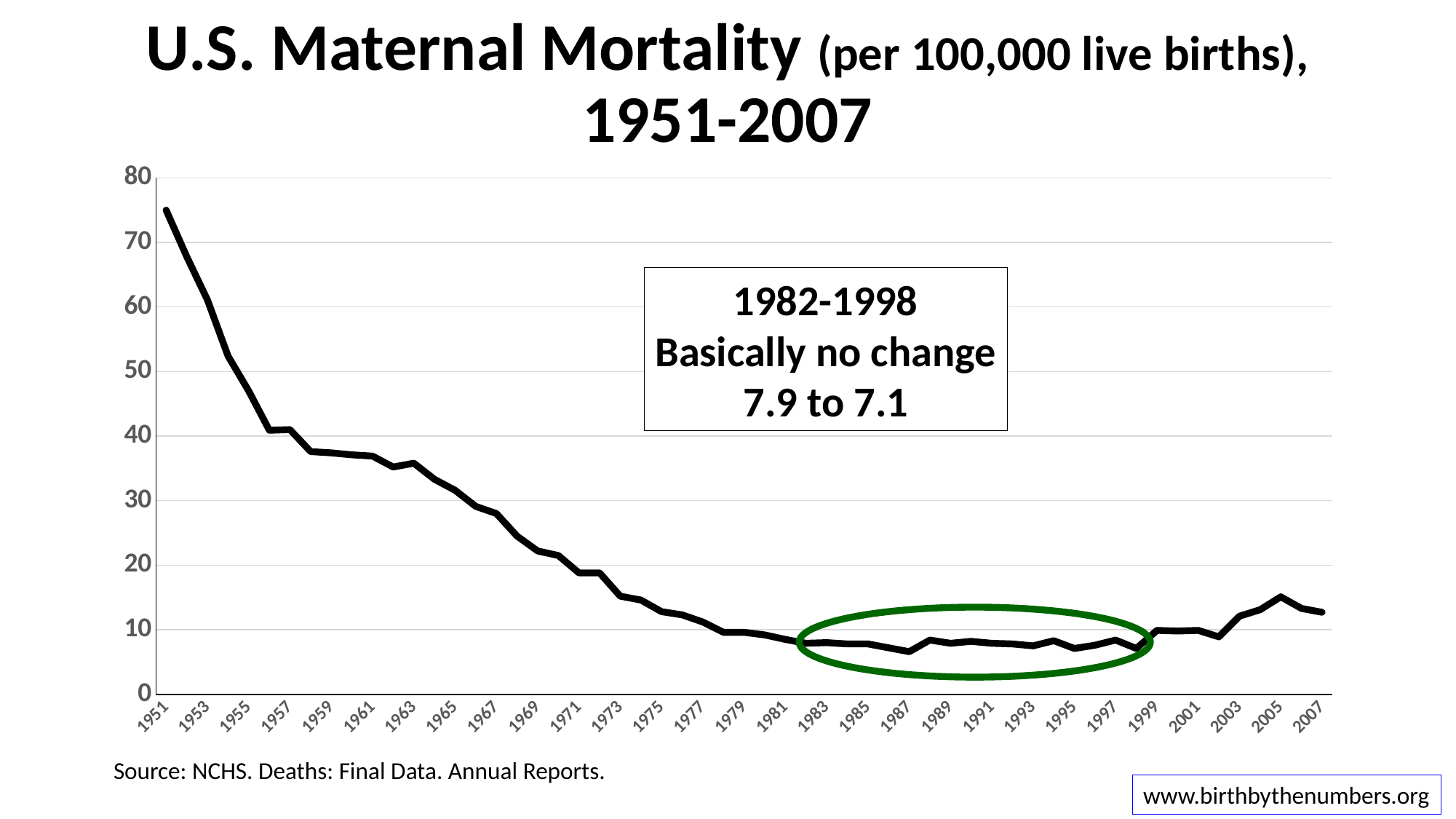
What kind of chart is shown on the slide? line chart Is the value for 1967 greater or less than 30? less According to the annotation box, what was the maternal mortality rate in 1982? 7.9 According to the annotation box, what was the maternal mortality rate in 1998? 7.1 Does the maternal mortality rate rise or fall from 1951 to 1981? fall Is the value for 1951 greater or less than 70? greater What is the difference between the 1982 value (7.9) and the 1998 value (7.1) given in the annotation? 0.8 What period does the annotation box describe as having 'basically no change'? 1982-1998 Is the value for 1973 greater or less than 20? less Which year has the highest maternal mortality rate on the chart? 1951